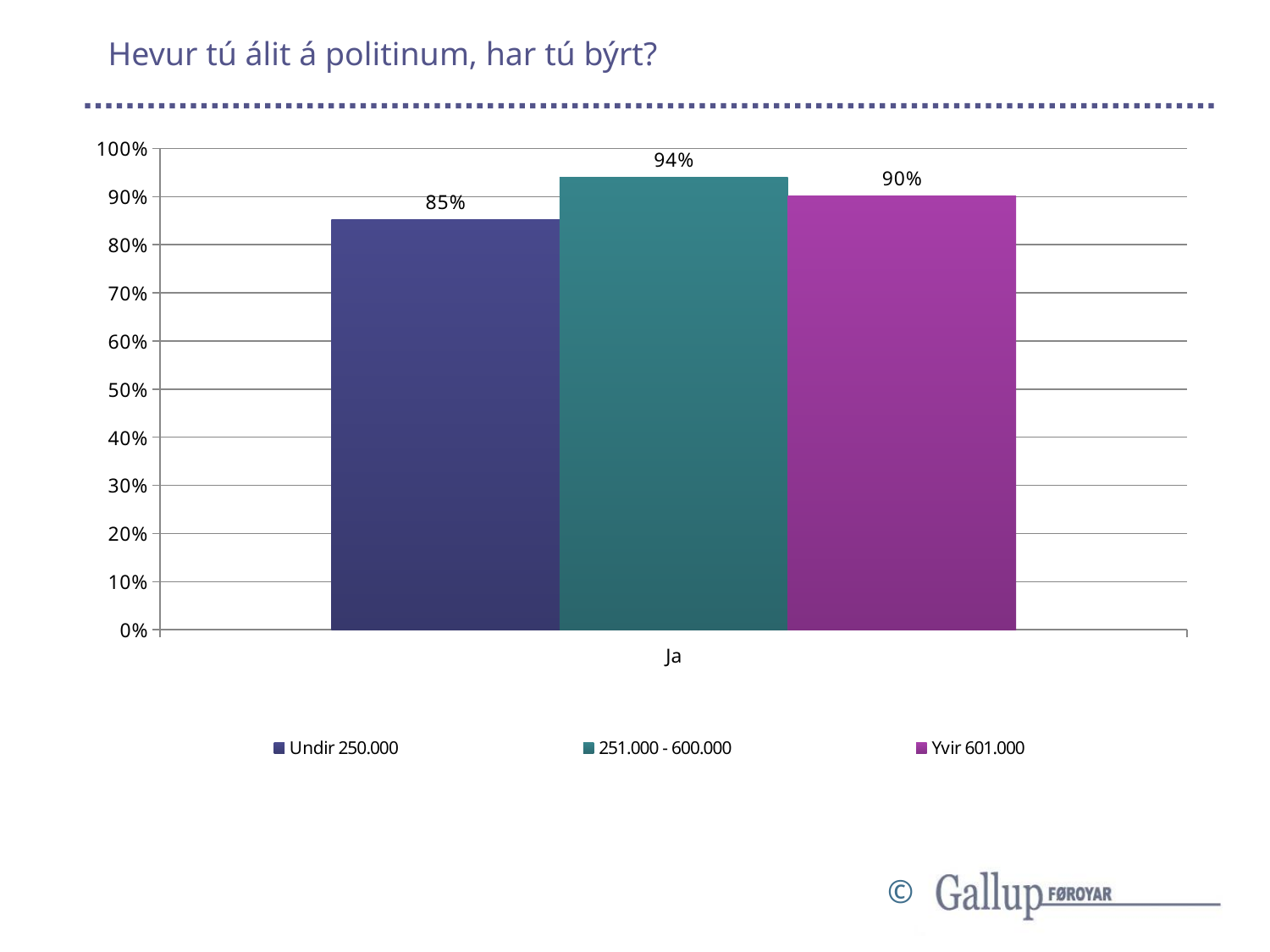
What is the difference between the values for '251.000 - 600.000' and 'Undir 250.000'? 9% What is the category label shown on the x axis? Ja What is the difference between the values for 'Yvir 601.000' and 'Undir 250.000'? 5% Which is larger, the value for 'Yvir 601.000' or the value for 'Undir 250.000'? Yvir 601.000 What is the value for the 'Undir 250.000' series? 85% Which series has the lowest value? Undir 250.000 How many series does the legend list? 3 What kind of chart is shown on the slide? bar chart What is the value for the '251.000 - 600.000' series? 94% What is the value for the 'Yvir 601.000' series? 90% Which series has the highest value? 251.000 - 600.000 Is the value for 'Undir 250.000' greater or less than 90%? less